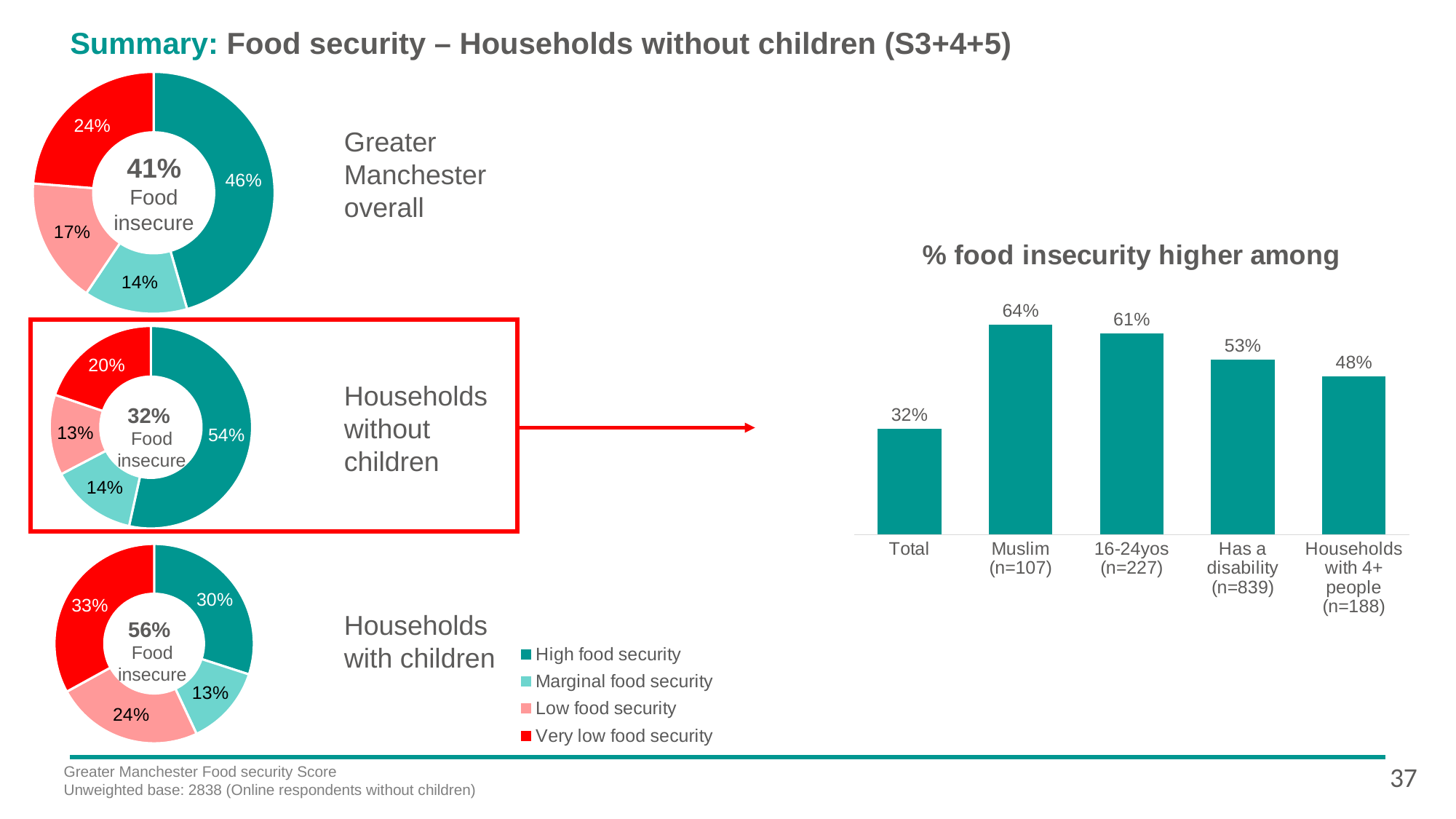
In the '% food insecurity higher among' bar chart, which category has the lowest value? Total In the 'Greater Manchester overall' donut chart, what share is High food security? 46% How many categories are shown in the '% food insecurity higher among' bar chart? 5 In the '% food insecurity higher among' bar chart, which category has the highest value? Muslim (n=107) How many entries does the legend for the donut charts list? 4 In the 'Households with children' donut chart, which segment is the largest? Very low food security What kind of chart is the '% food insecurity higher among' chart? Bar chart In the 'Households with children' donut chart, what share is Low food security? 24% In the 'Households without children' donut chart, what share is Very low food security? 20% In the '% food insecurity higher among' bar chart, which is larger: Has a disability (n=839) or Households with 4+ people (n=188)? Has a disability (n=839) In the '% food insecurity higher among' bar chart, what is the value for Muslim (n=107)? 64% In the '% food insecurity higher among' bar chart, what is the difference between the values for 16-24yos (n=227) and Total? 29%